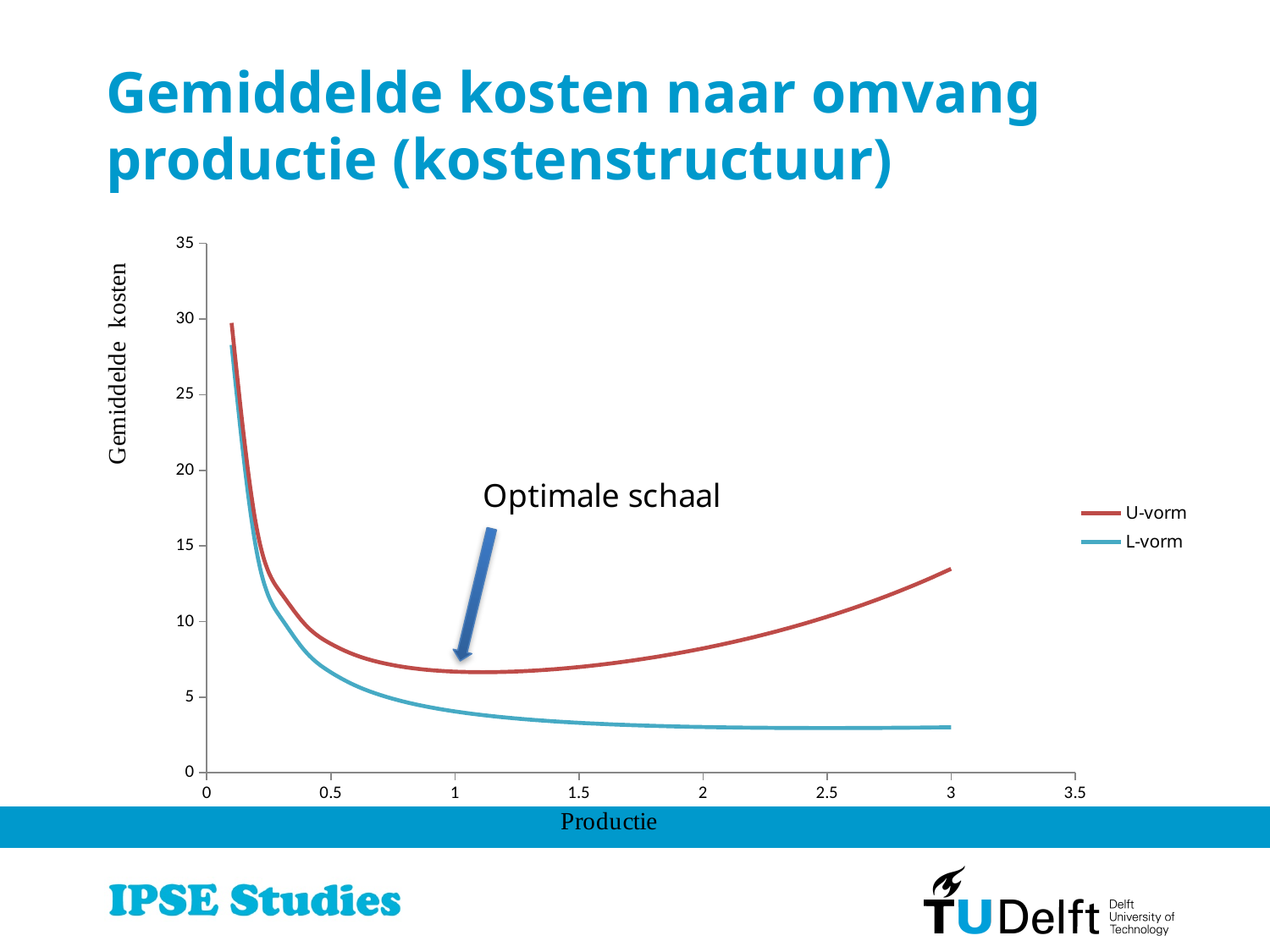
Is the value of the U-vorm line at Productie 1 greater or less than 10? less How many series does the legend list? 2 What is the label of the horizontal axis? Productie Is the value of the L-vorm line at Productie 3 greater or less than 5? less Does the L-vorm line rise or fall as Productie increases from 0 to 3? fall Does the U-vorm line rise or fall as Productie increases from 1.5 to 3? rise At Productie 2, which series has the higher Gemiddelde kosten, U-vorm or L-vorm? U-vorm Is the value of the L-vorm line at Productie 1 greater or less than 10? less What kind of chart is shown on the slide? Line chart Which series reaches the lowest Gemiddelde kosten on the chart? L-vorm What are the two series named in the legend? U-vorm and L-vorm